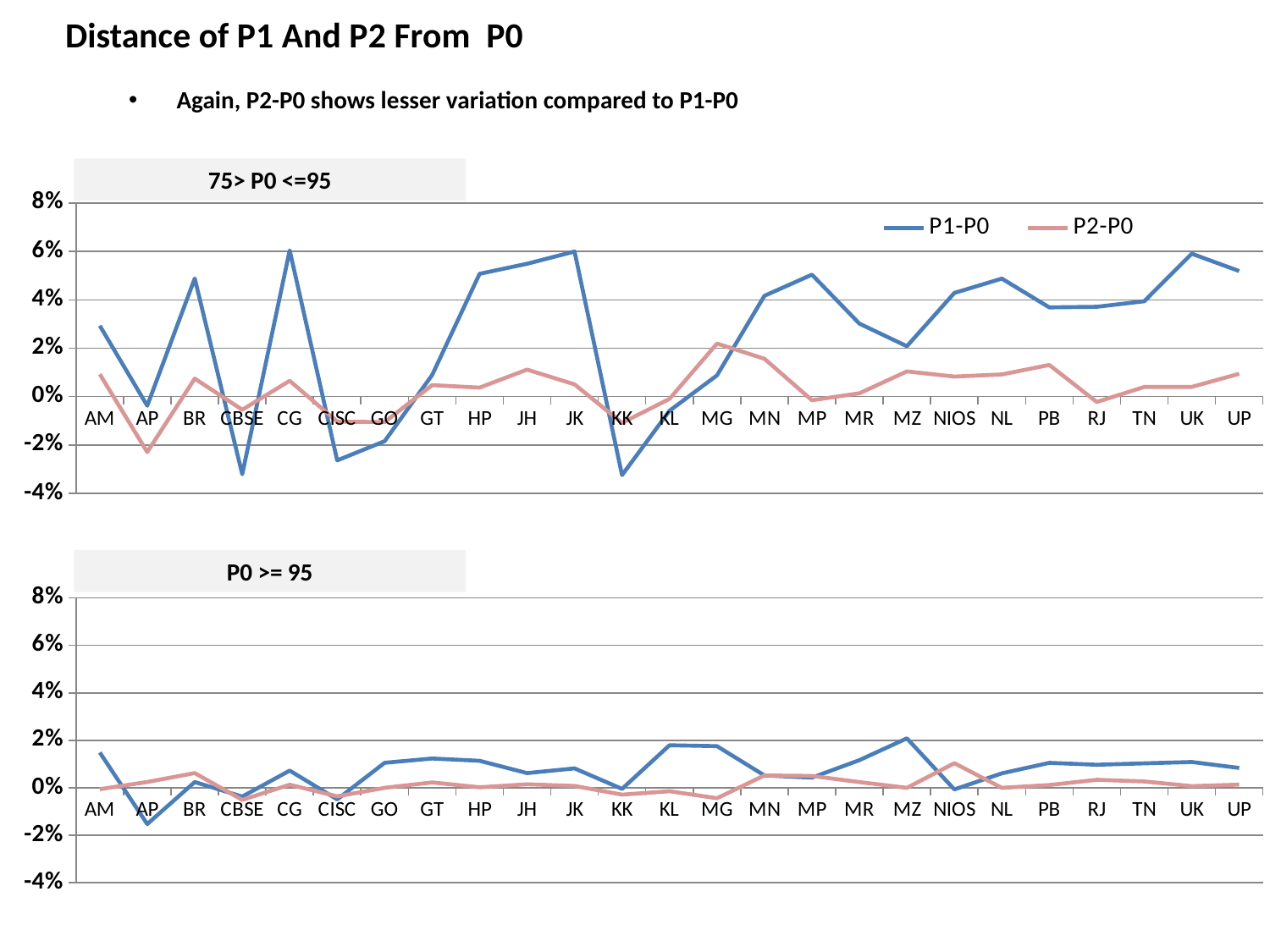
In the bottom chart "P0 >= 95", is the P1-P0 value for KL greater or less than 1%? greater In the top chart "75> P0 <=95", is the P1-P0 value for HP greater or less than 4%? greater What type of chart is the top chart titled "75> P0 <=95"? line chart In the bottom chart "P0 >= 95", is the P1-P0 value for AP greater or less than -1%? less How many series does the legend of the top chart list? 2 In the bottom chart "P0 >= 95", which category has the lowest P1-P0 value? AP What are the two series names shown in the legend of the top chart? P1-P0 and P2-P0 In the bottom chart "P0 >= 95", which series has the larger value at NIOS, P1-P0 or P2-P0? P2-P0 How many categories are shown on the x axis of the bottom chart titled "P0 >= 95"? 25 In the top chart "75> P0 <=95", which series has the larger value at HP, P1-P0 or P2-P0? P1-P0